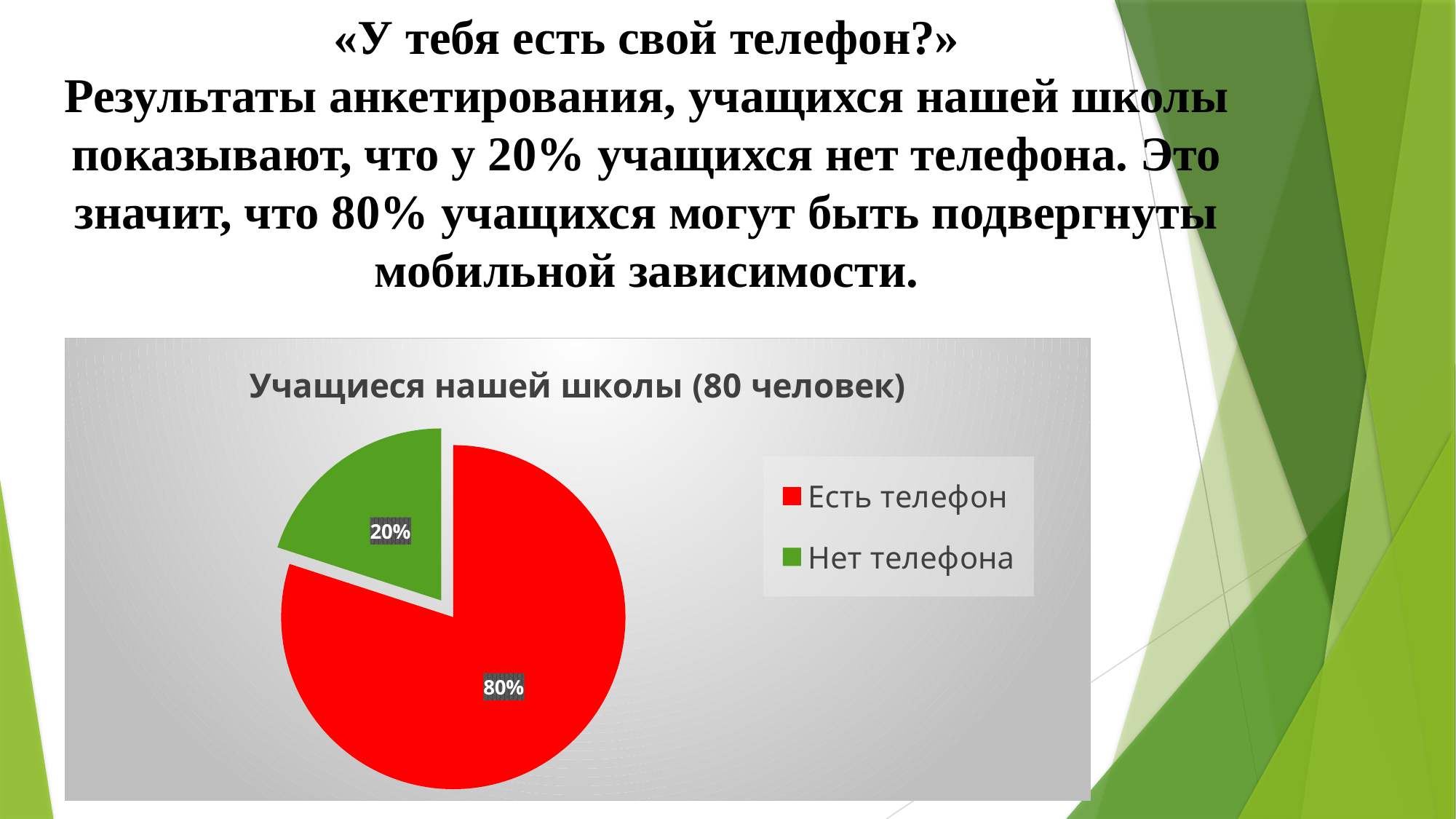
Which is larger, the slice for "Есть телефон" or the slice for "Нет телефона"? Есть телефон What is the total of the two slice percentages shown on the pie? 100% What is the title of the chart? Учащиеся нашей школы (80 человек) What share of the pie is labelled "Есть телефон"? 80% Which category has the largest slice of the pie? Есть телефон How many entries does the legend list? 2 How many slices does the pie chart have? 2 What is the difference in percentage points between "Есть телефон" and "Нет телефона"? 60% What colour is the slice for "Нет телефона"? green Which category has the smallest slice of the pie? Нет телефона What share of the pie is labelled "Нет телефона"? 20% What kind of chart is shown on the slide? pie chart